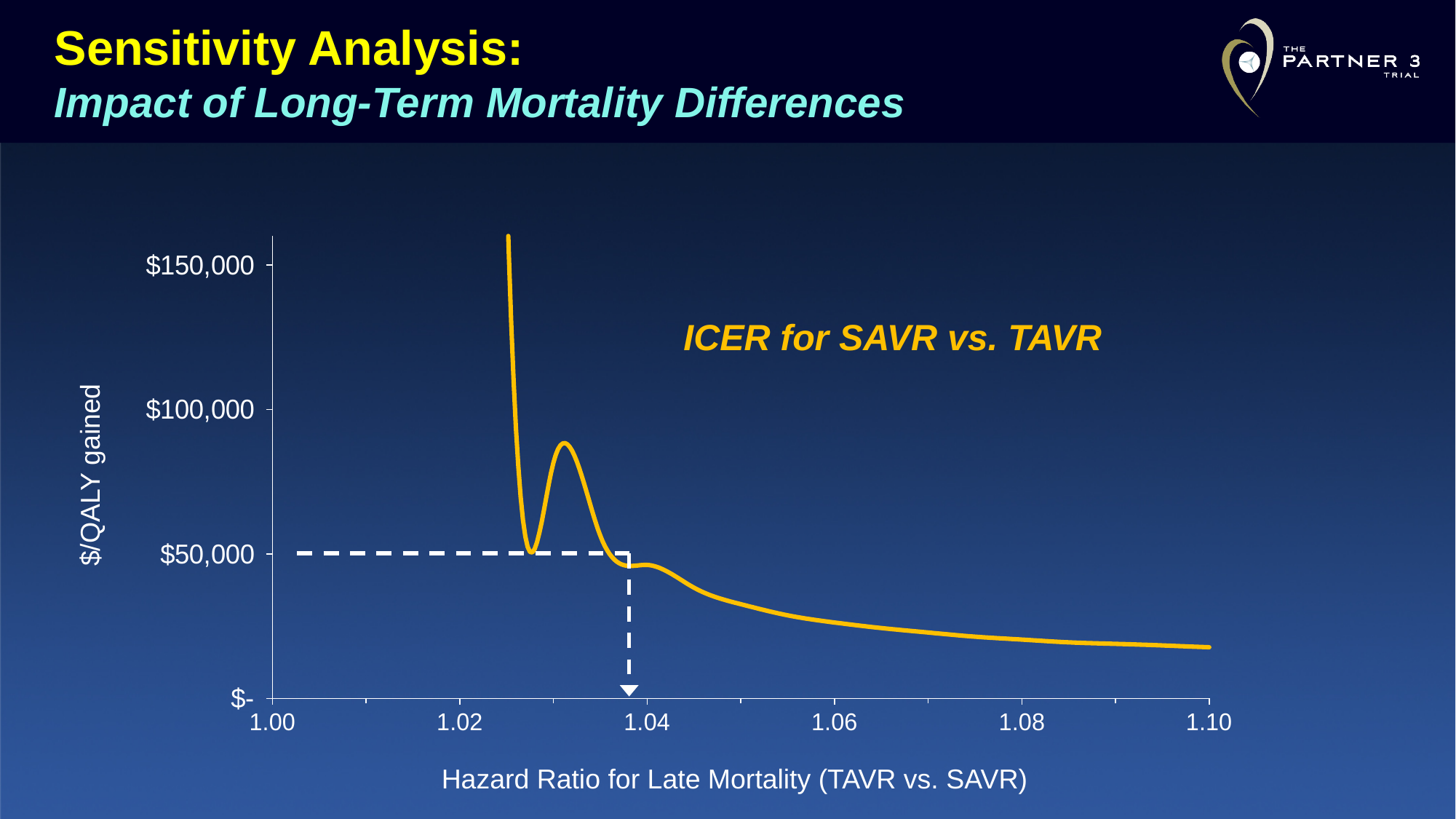
What is the highest value shown on the y axis? $150,000 Is the ICER value at a hazard ratio of 1.06 greater or less than $100,000? less Is the ICER value at a hazard ratio of 1.03 greater or less than $50,000? greater Is the ICER value at a hazard ratio of 1.08 greater or less than $50,000? less Which is larger, the ICER at a hazard ratio of 1.04 or at 1.10? 1.04 Does the ICER curve rise or fall as the hazard ratio increases from 1.04 to 1.10? fall What is the label of the y axis? $/QALY gained What is the highest hazard ratio shown on the x axis? 1.10 What kind of chart is shown on the slide? Line chart